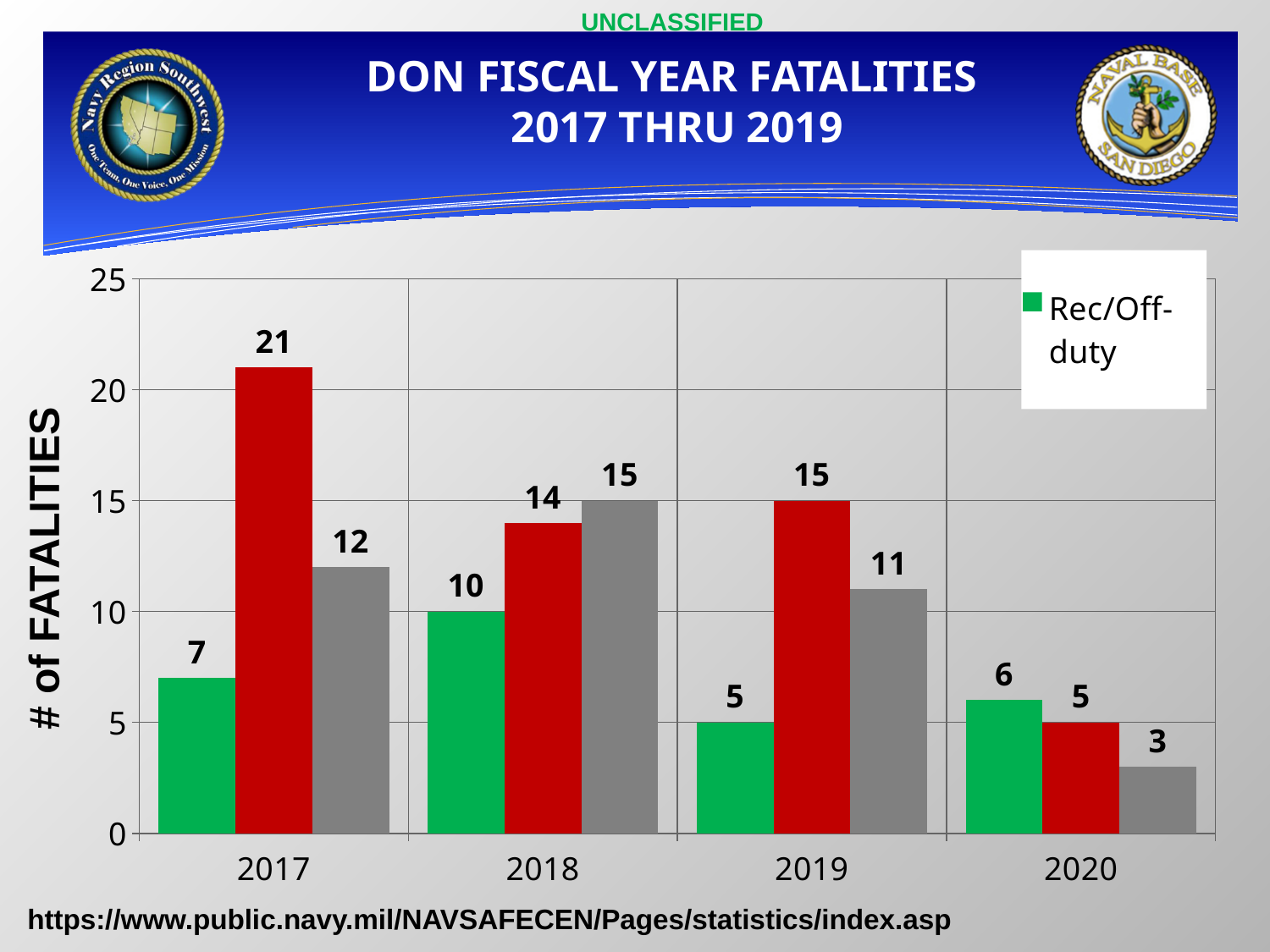
Which year has the highest Rec/Off-duty value? 2018 What is the value of the red bar for 2017? 21 What is the label on the vertical axis? # of FATALITIES How many bars are shown for each year? 3 How many years are shown on the x axis? 4 What is the difference between the red bar and the gray bar for 2017? 9 Which year has the lowest Rec/Off-duty value? 2019 Which is larger for 2018, the red bar or the gray bar? the gray bar What is the Rec/Off-duty value for 2017? 7 What kind of chart is shown on the slide? bar chart What is the Rec/Off-duty value for 2018? 10 What is the value of the gray bar for 2020? 3